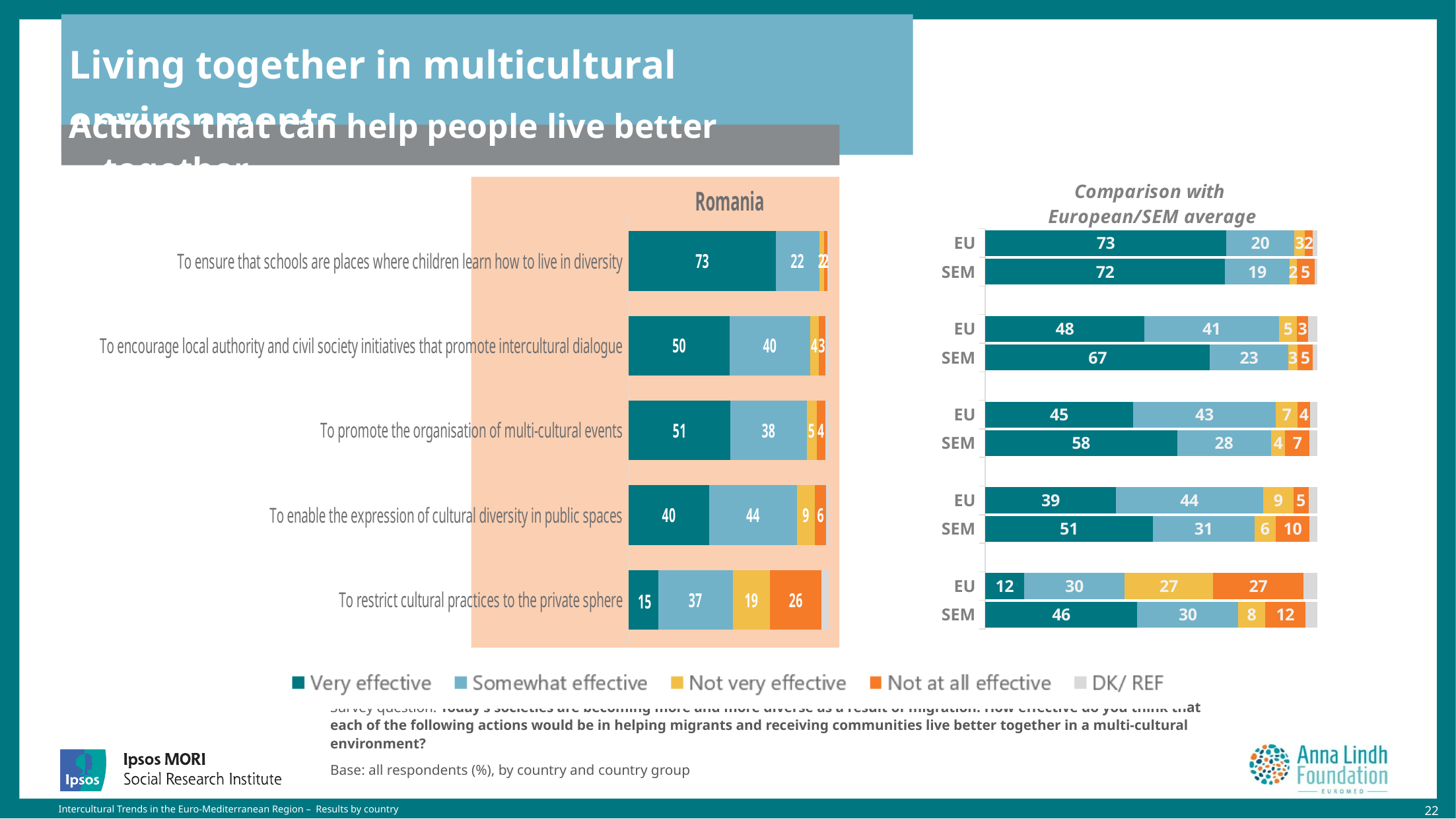
In the Comparison with European/SEM average chart, what is the SEM Very effective value for 'To encourage local authority and civil society initiatives that promote intercultural dialogue'? 67 In the Romania chart, which action has the lowest Very effective value? To restrict cultural practices to the private sphere In the Comparison with European/SEM average chart, what is the EU Not at all effective value for 'To restrict cultural practices to the private sphere'? 27 In the Romania chart, what is the difference between the Very effective values for 'To promote the organisation of multi-cultural events' and 'To enable the expression of cultural diversity in public spaces'? 11 How many actions (categories) are shown in the Romania chart? 5 In the Comparison with European/SEM average chart, what is the difference between the SEM and EU Very effective values for 'To restrict cultural practices to the private sphere'? 34 In the Romania chart, what percentage rated 'To restrict cultural practices to the private sphere' as Not at all effective? 26 In the Comparison with European/SEM average chart, for 'To promote the organisation of multi-cultural events', which has the larger Very effective value, EU or SEM? SEM In the Romania chart, which action has the highest Very effective value? To ensure that schools are places where children learn how to live in diversity How many series does the legend list? 5 In the Romania chart, what percentage rated 'To ensure that schools are places where children learn how to live in diversity' as Very effective? 73 What kind of chart is the Romania chart? Stacked bar chart